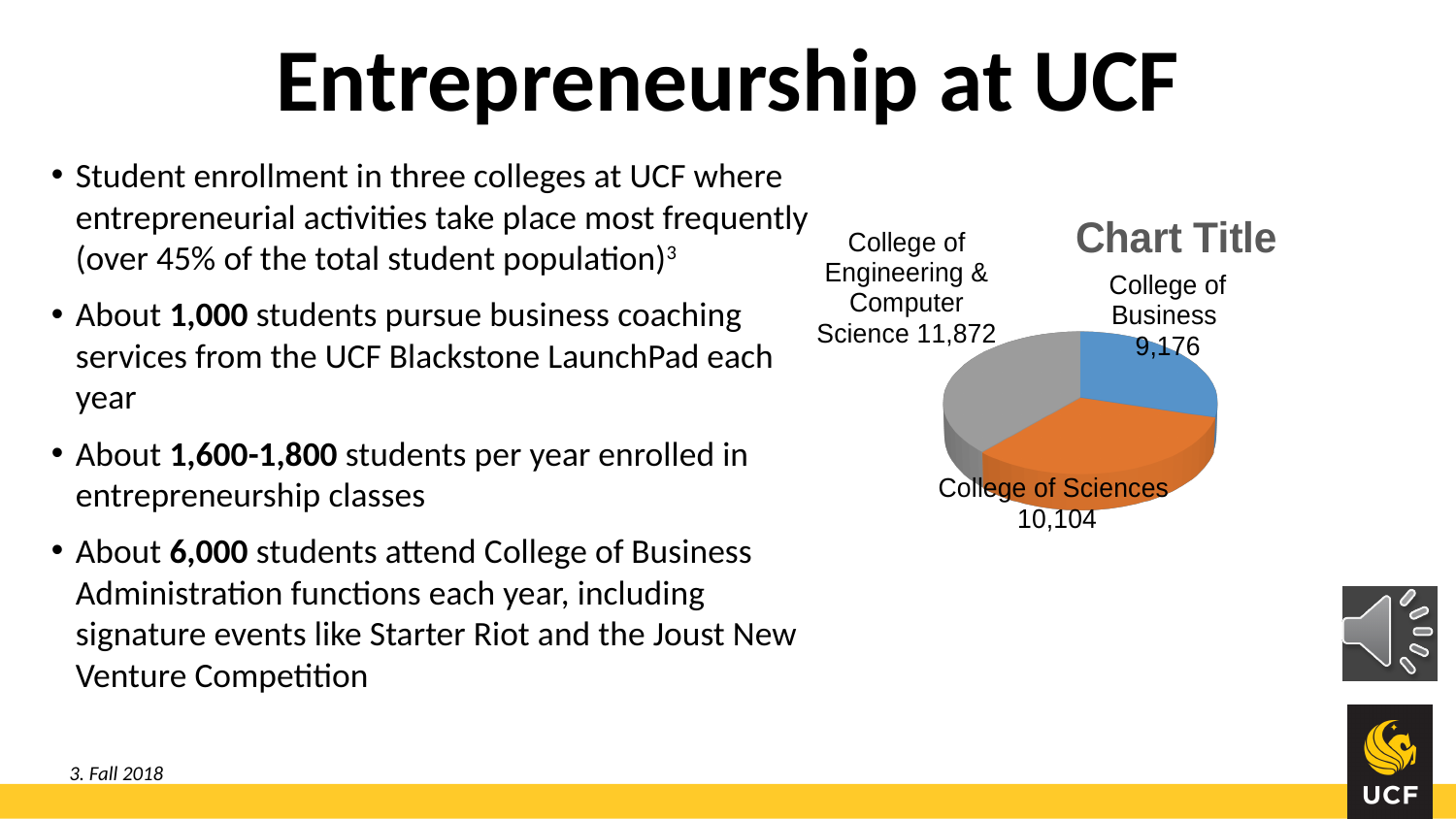
How many slices does the pie chart have? 3 Which college has the smallest slice in the pie chart? College of Business What is the difference between the College of Sciences value and the College of Business value? 928 What type of chart is shown on the slide? Pie chart Which is larger, the value for the College of Sciences or the value for the College of Business? College of Sciences What is the title shown on the chart? Chart Title What is the enrollment value shown for the College of Business? 9,176 Which college has the largest slice in the pie chart? College of Engineering & Computer Science What is the enrollment value shown for the College of Sciences? 10,104 What is the enrollment value shown for the College of Engineering & Computer Science? 11,872 What is the difference between the College of Engineering & Computer Science value and the College of Business value? 2,696 What colour is the College of Sciences slice? Orange